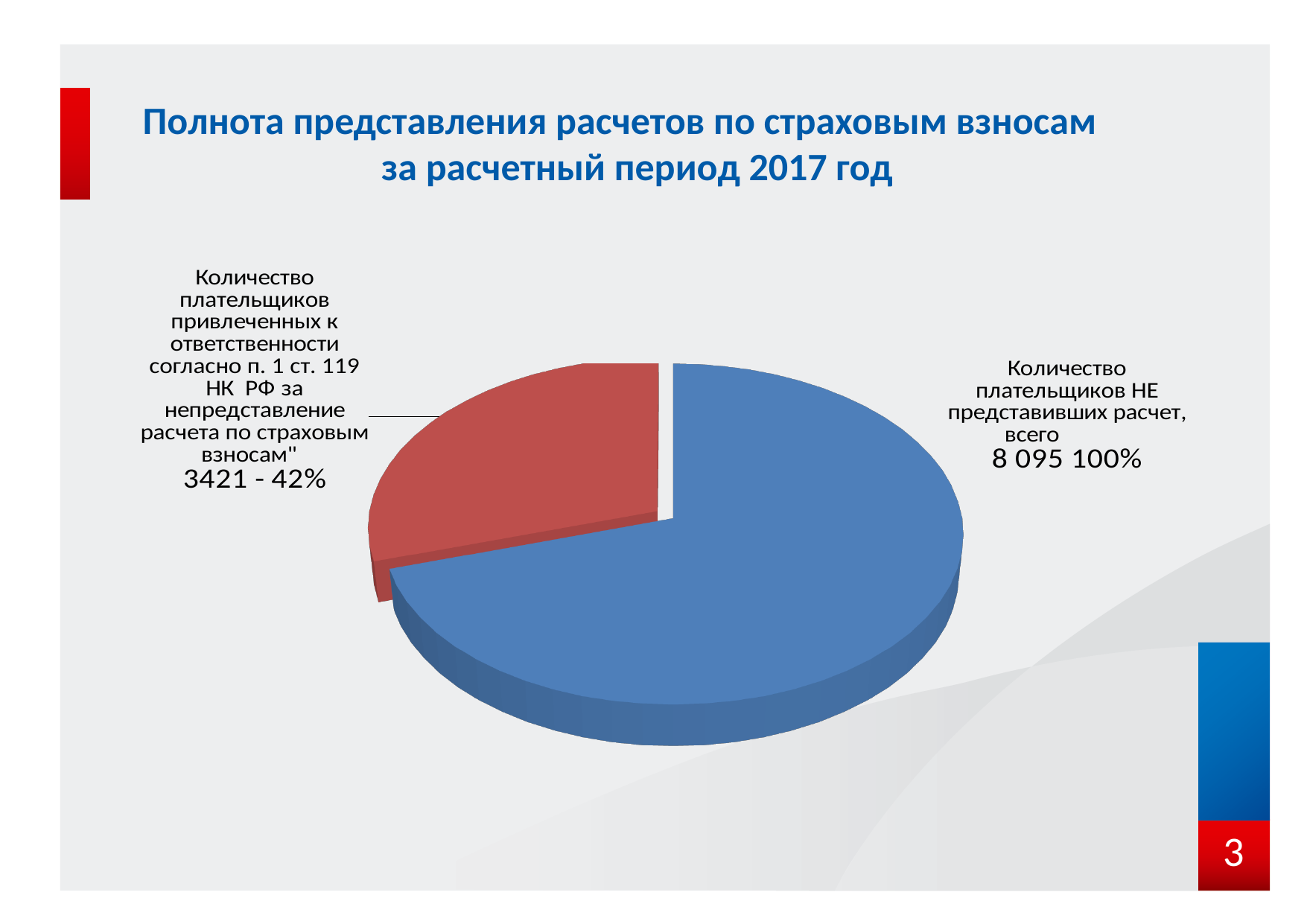
What colour is the slice for "Количество плательщиков привлеченных к ответственности согласно п. 1 ст. 119 НК РФ"? Red Which is larger: the value for "Количество плательщиков НЕ представивших расчет, всего" or the value for "Количество плательщиков привлеченных к ответственности"? Количество плательщиков НЕ представивших расчет, всего What value is shown for the slice "Количество плательщиков НЕ представивших расчет, всего"? 8 095 Which slice of the pie chart is the smallest? Количество плательщиков привлеченных к ответственности согласно п. 1 ст. 119 НК РФ за непредставление расчета по страховым взносам What kind of chart is shown on the slide? Pie chart What percentage share is printed for the slice "Количество плательщиков привлеченных к ответственности согласно п. 1 ст. 119 НК РФ"? 42% How many slices does the pie chart have? 2 What is the title of the slide containing the pie chart? Полнота представления расчетов по страховым взносам за расчетный период 2017 год Which slice of the pie chart is the largest? Количество плательщиков НЕ представивших расчет, всего What value is shown for the slice "Количество плательщиков привлеченных к ответственности согласно п. 1 ст. 119 НК РФ за непредставление расчета по страховым взносам"? 3421 What is the difference between the value for "Количество плательщиков НЕ представивших расчет, всего" (8 095) and the value for "Количество плательщиков привлеченных к ответственности" (3421)? 4674